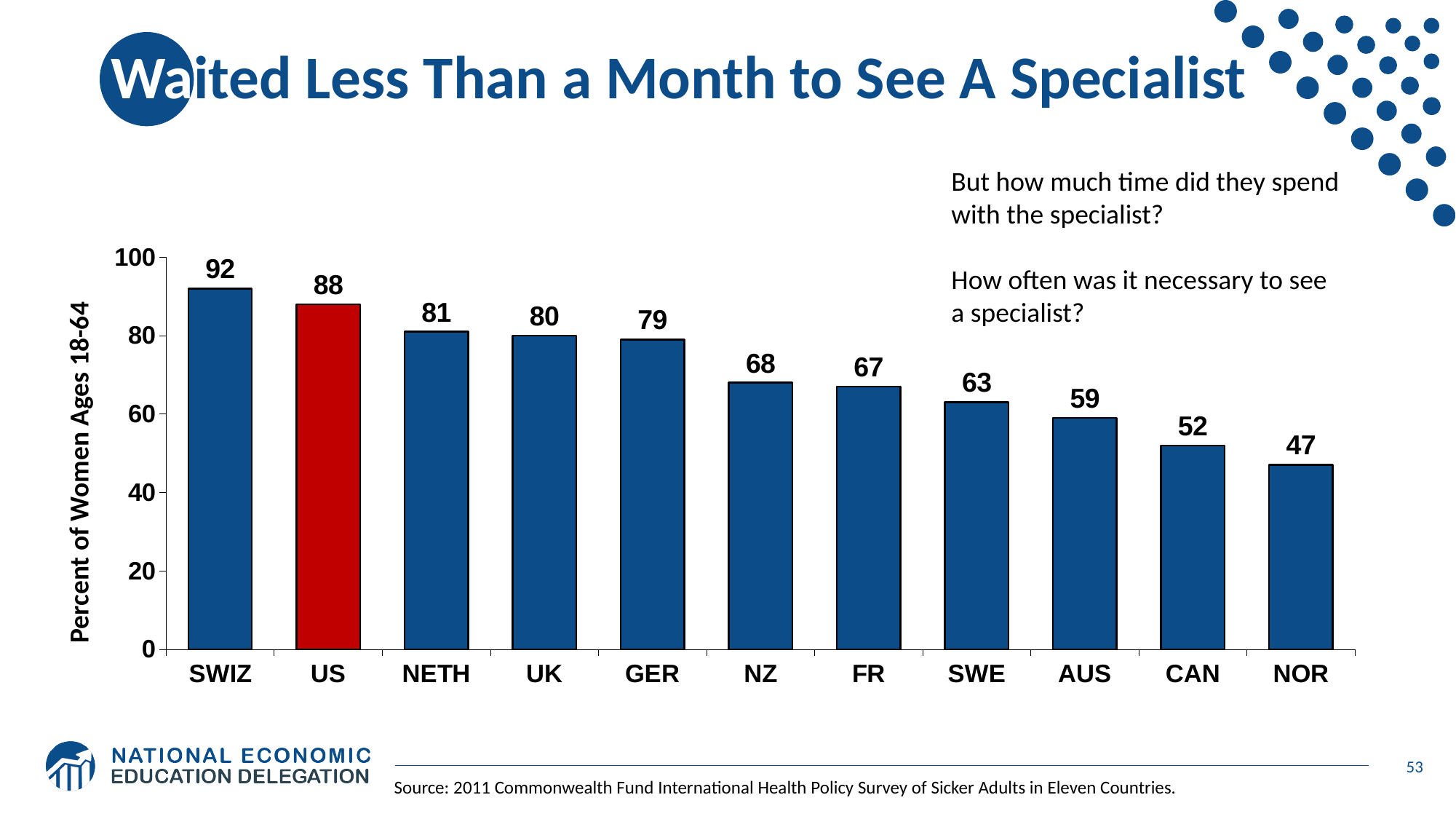
Which country has the lowest value? NOR Which has a larger value, NZ or SWE? NZ Which country's bar is coloured red? US How many countries are shown on the chart? 11 Which country has the highest value? SWIZ Is the value for AUS greater or less than 60? less What is the difference between the values for NETH and CAN? 29 What kind of chart is shown on the slide? bar chart What is the value for GER? 79 What is the value for the US? 88 What is the value for NOR? 47 What is the difference between the values for SWIZ and the US? 4